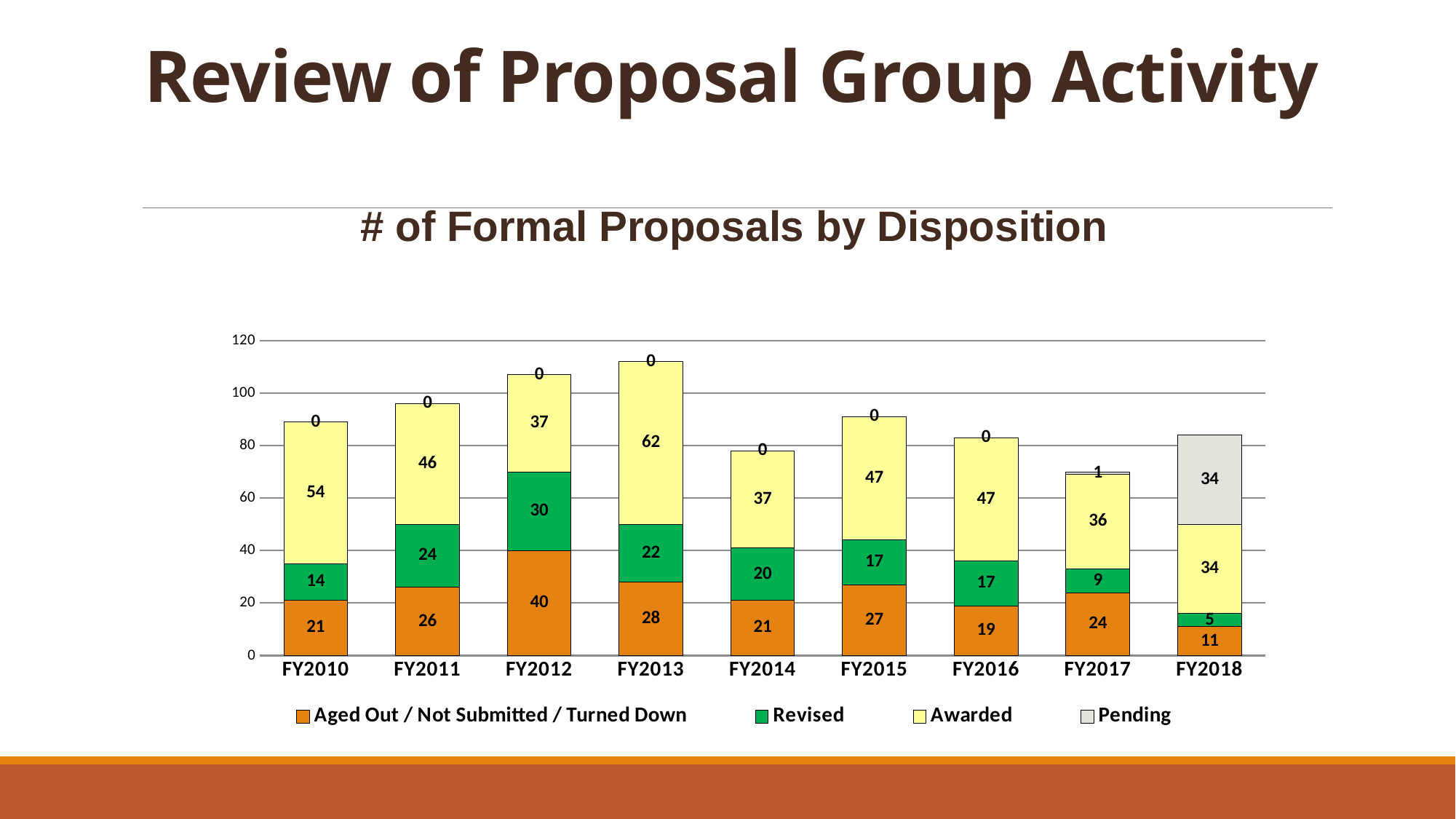
What is the difference between the Awarded values for FY2013 and FY2012? 25 What is the Revised value for FY2012? 30 What is the title of the chart? # of Formal Proposals by Disposition Which is larger, the Revised value for FY2011 or the Revised value for FY2014? FY2011 How many fiscal years are shown on the x axis of the chart? 9 What type of chart is shown on the slide? Stacked bar chart Which fiscal year has the lowest Revised value? FY2018 Which fiscal year has the highest Aged Out / Not Submitted / Turned Down value? FY2012 What is the Pending value for FY2018? 34 What is the Awarded value for FY2013? 62 What is the total of the stacked bar for FY2013? 112 How many series does the chart's legend list? 4